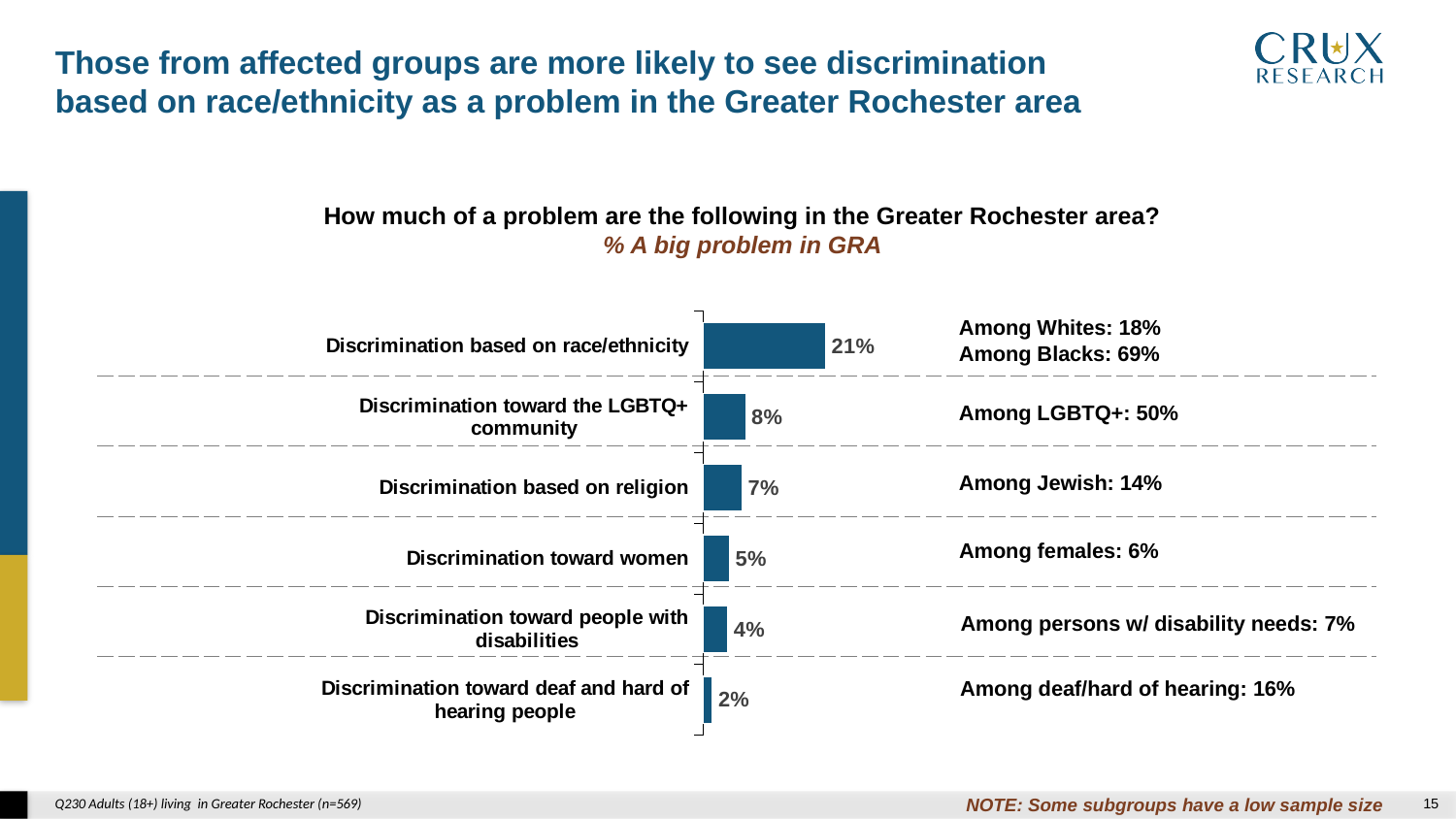
What is the subtitle of the chart shown in italics below the question text? % A big problem in GRA Which is larger: the percentage for discrimination toward women or the percentage for discrimination toward people with disabilities? Discrimination toward women What percentage say discrimination based on race/ethnicity is a big problem in the Greater Rochester area? 21% Do the values decrease from the top bar to the bottom bar? Yes Which category has the highest share saying it is a big problem in GRA? Discrimination based on race/ethnicity What percentage say discrimination toward deaf and hard of hearing people is a big problem in GRA? 2% What is the difference between the percentage for discrimination based on race/ethnicity and the percentage for discrimination based on religion? 14% Which category has the lowest share saying it is a big problem in GRA? Discrimination toward deaf and hard of hearing people According to the annotation next to the chart, what percentage of Blacks see discrimination based on race/ethnicity as a big problem? 69% How many categories are shown in the bar chart? 6 What percentage say discrimination toward the LGBTQ+ community is a big problem in GRA? 8% What kind of chart is shown on the slide? Bar chart